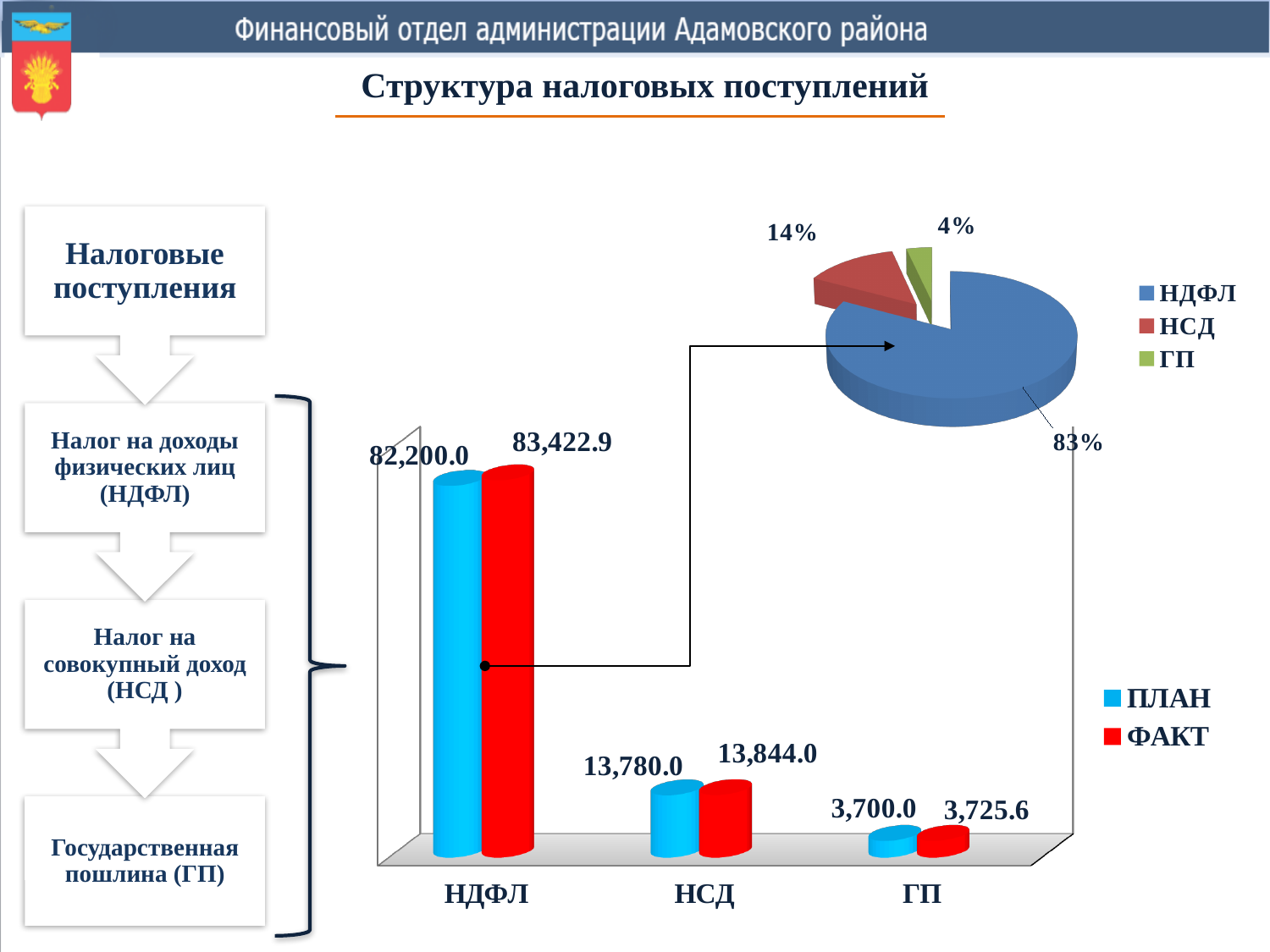
In the bar chart at the bottom of the slide, which is larger for ГП: the ПЛАН value or the ФАКТ value? ФАКТ What kind of chart is the chart in the top right of the slide? Pie chart How many categories are shown on the x axis of the bar chart at the bottom of the slide? 3 In the bar chart at the bottom of the slide, which category has the highest ФАКТ value? НДФЛ How many series does the legend of the bar chart at the bottom of the slide list? 2 In the pie chart in the top right of the slide, which slice is the largest? НДФЛ In the bar chart at the bottom of the slide, what is the ФАКТ value for ГП? 3,725.6 In the bar chart at the bottom of the slide, what is the ФАКТ value for НСД? 13,844.0 In the bar chart at the bottom of the slide, what is the difference between the ФАКТ and ПЛАН values for НДФЛ? 1,222.9 In the bar chart at the bottom of the slide, which category has the lowest ПЛАН value? ГП In the bar chart at the bottom of the slide, what is the ПЛАН value for НДФЛ? 82,200.0 In the pie chart in the top right of the slide, what share does НСД have? 14%